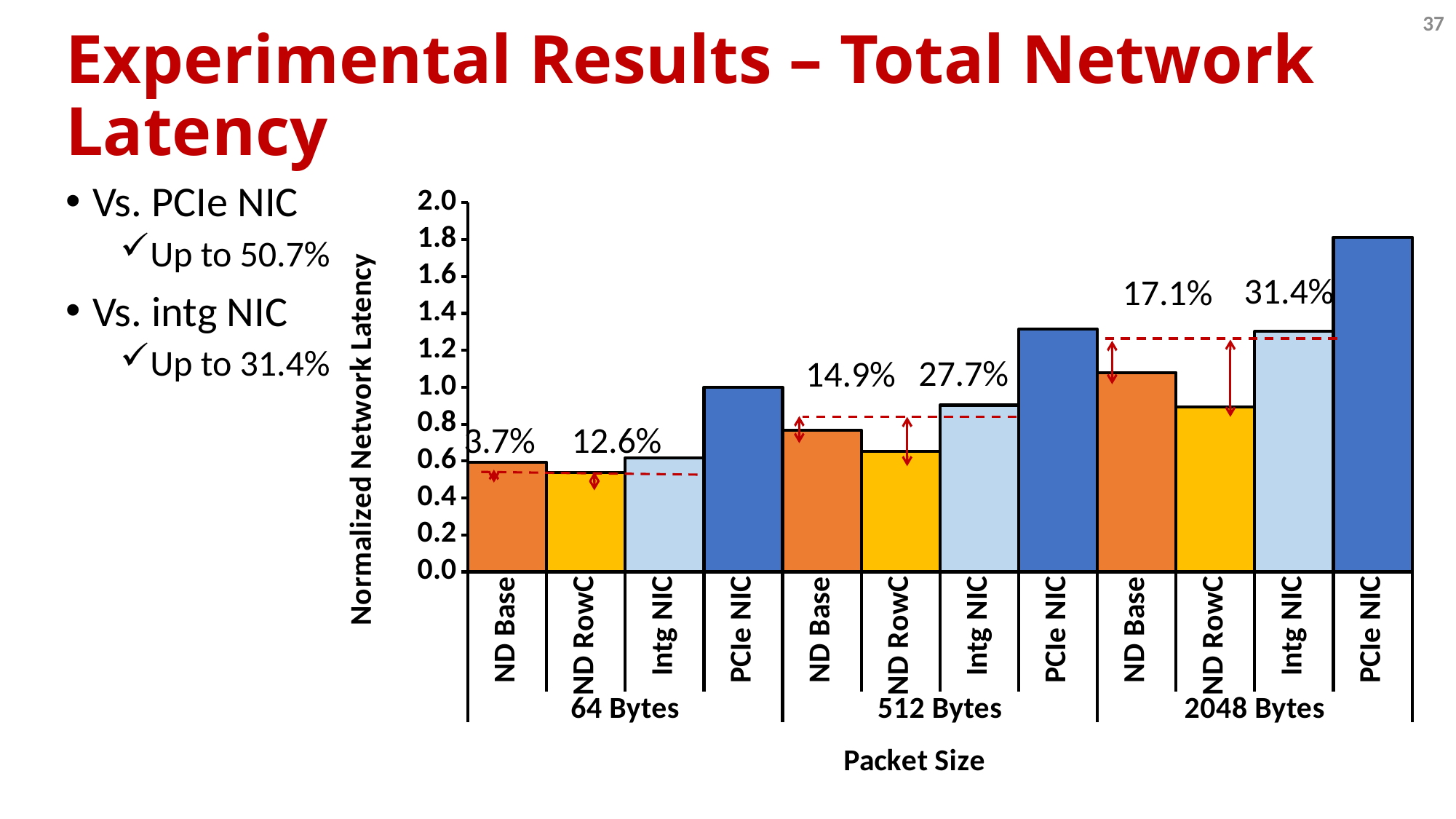
Which bar has the highest normalized network latency? PCIe NIC at 2048 Bytes What is the label of the y axis? Normalized Network Latency Is the normalized network latency for Intg NIC at 512 Bytes greater or less than 0.8? greater What kind of chart is shown on the slide? bar chart Which bar has the lowest normalized network latency? ND RowC at 64 Bytes At 512 Bytes, which has the higher normalized network latency, ND Base or ND RowC? ND Base Is the normalized network latency for PCIe NIC at 2048 Bytes greater or less than 1.6? greater How does the normalized network latency of PCIe NIC change as packet size increases from 64 Bytes to 2048 Bytes? It rises How many bars are plotted in the chart? 12 Is the normalized network latency for ND RowC at 64 Bytes greater or less than 0.6? less What is the normalized network latency of PCIe NIC at 64 Bytes? 1.0 What percentage is annotated above the ND RowC bar at 2048 Bytes? 31.4%